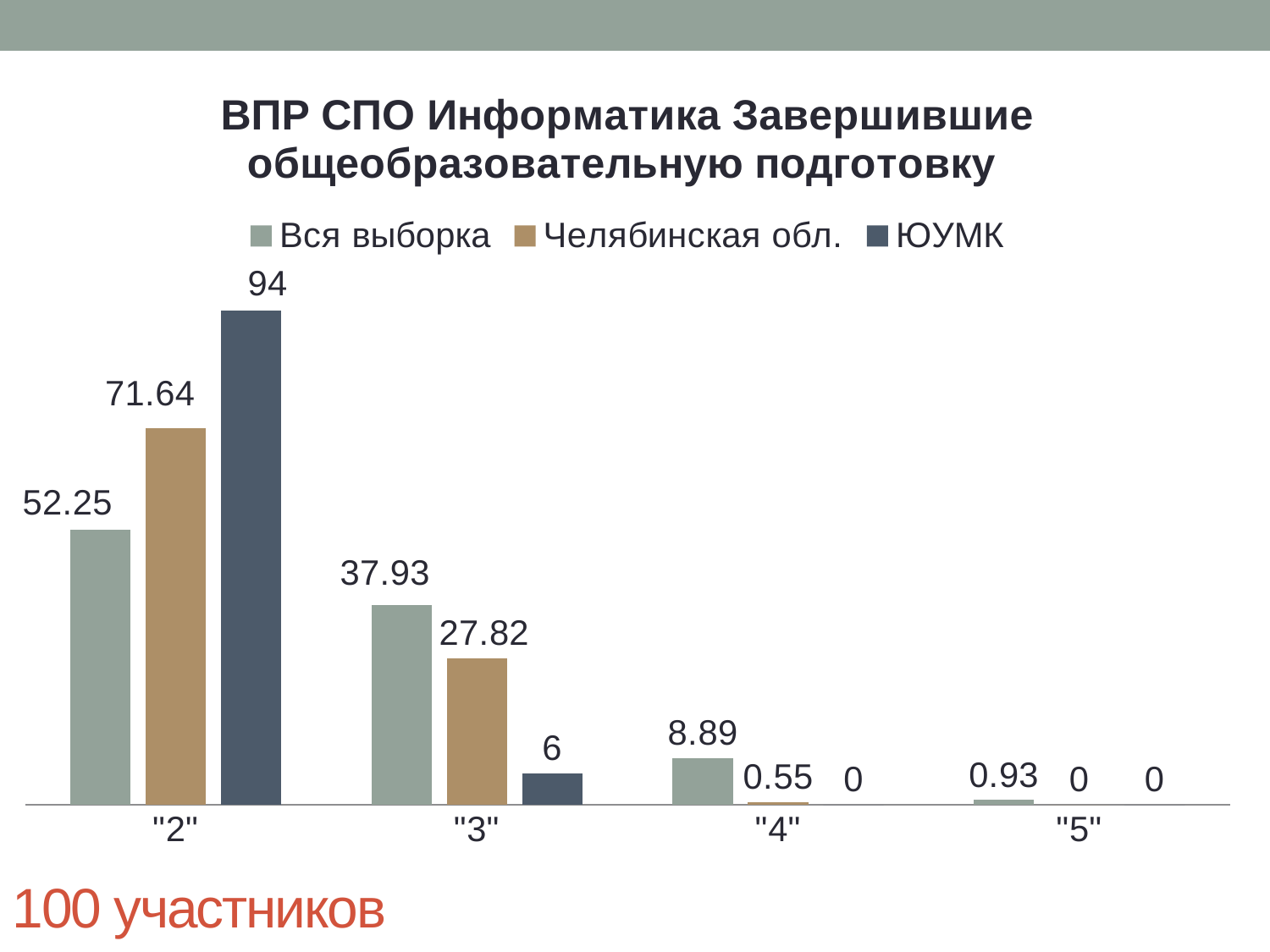
What is the value for Челябинская обл. in category "3"? 27.82 Which category has the lowest value for Вся выборка? "5" What is the title of the chart? ВПР СПО Информатика Завершившие общеобразовательную подготовку Do the values for Челябинская обл. rise or fall from "2" to "5"? fall What is the value for ЮУМК in category "2"? 94 What is the difference between the ЮУМК and Вся выборка values in category "2"? 41.75 Which is larger in category "3": Вся выборка or Челябинская обл.? Вся выборка What kind of chart is shown? bar chart Which category has the highest value for Вся выборка? "2" What is the value for Вся выборка in category "4"? 8.89 How many categories are shown on the x axis? 4 How many series does the legend list? 3